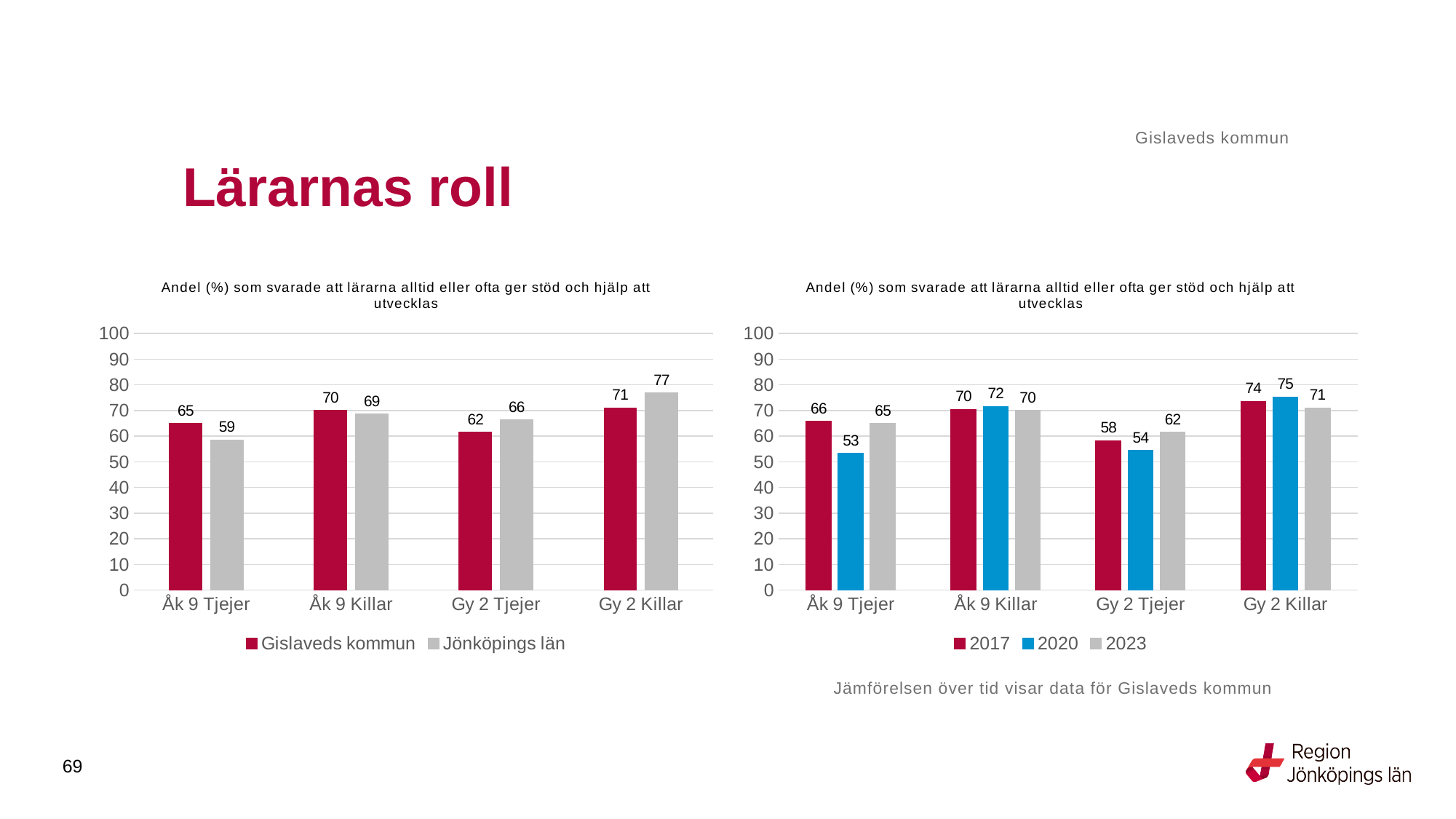
In the right chart, what is the difference between 2017 and 2020 for Åk 9 Tjejer? 13 What kind of chart is the right chart? Bar chart In the left chart, which category has the lowest value for Jönköpings län? Åk 9 Tjejer In the left chart, what is the value for Jönköpings län for Gy 2 Killar? 77 In the right chart, which category has the highest value for 2017? Gy 2 Killar In the left chart, what is the value for Gislaveds kommun for Åk 9 Tjejer? 65 In the left chart, which is larger for Gy 2 Tjejer: Gislaveds kommun or Jönköpings län? Jönköpings län In the left chart, what is the difference between Jönköpings län and Gislaveds kommun for Gy 2 Killar? 6 In the right chart, what is the value for 2020 for Åk 9 Tjejer? 53 In the right chart, what is the value for 2023 for Gy 2 Tjejer? 62 In the left chart, how many series does the legend list? 2 In the right chart, how many categories are shown on the x axis? 4